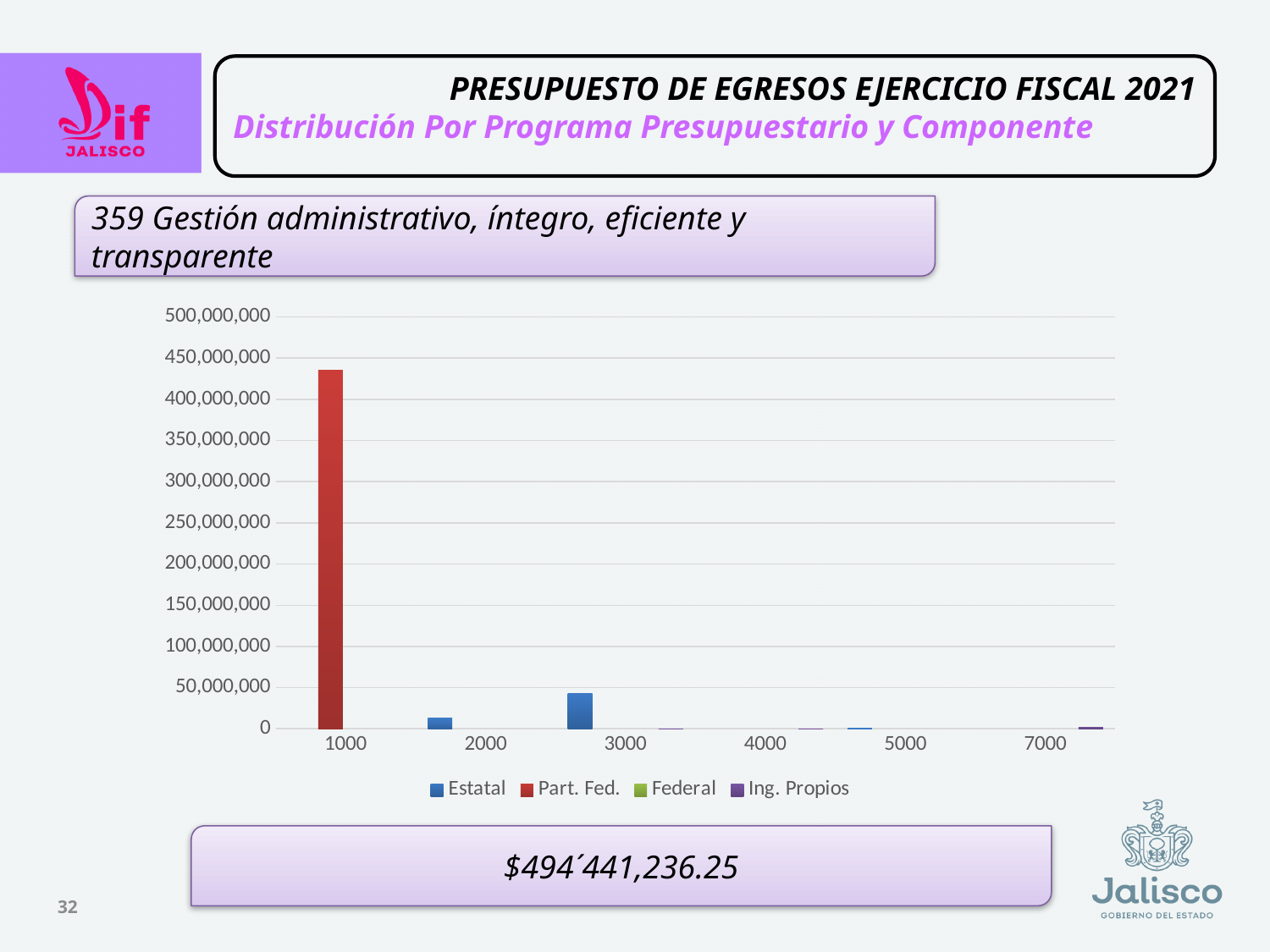
Is the Estatal value for category 2000 greater or less than 50,000,000? less How many categories are shown on the x axis of the chart? 6 Is the Part. Fed. value for category 1000 greater or less than 400,000,000? greater Which series has the tallest bar in the chart? Part. Fed. How many series does the chart legend list? 4 Which is larger, the Estatal value for category 3000 or the Estatal value for category 2000? 3000 What is the highest value shown on the chart's y axis? 500,000,000 What kind of chart is shown on the slide? Bar chart What colour represents the Part. Fed. series in the chart legend? Red Which is larger, the Part. Fed. value for category 1000 or the Estatal value for category 3000? Part. Fed. for 1000 Which category has the tallest bar in the chart? 1000 Is the Estatal value for category 3000 greater or less than 50,000,000? less